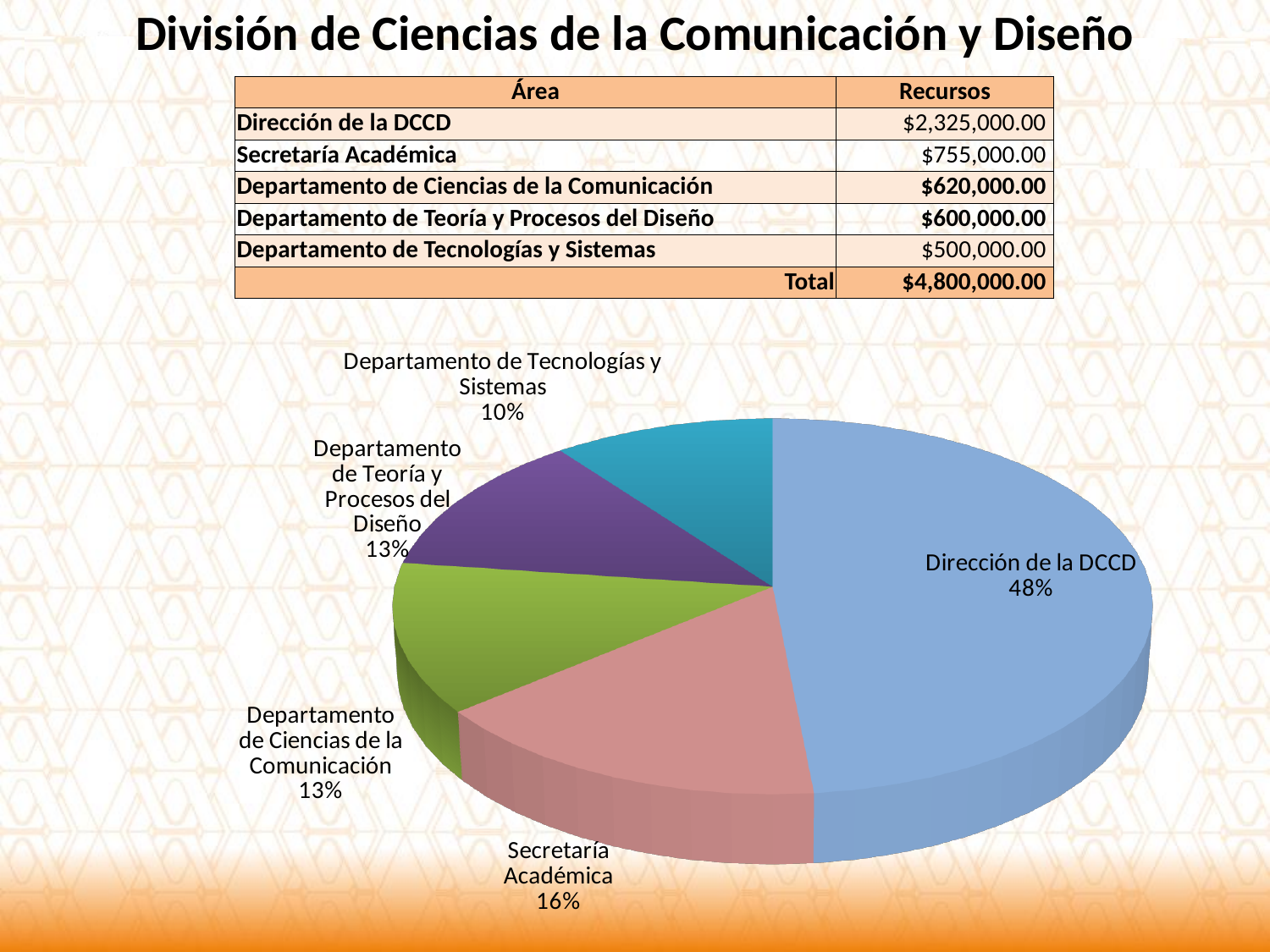
What share of the pie does Departamento de Tecnologías y Sistemas hold? 10% Which slice of the pie chart is the largest? Dirección de la DCCD What percentage is shown for Departamento de Teoría y Procesos del Diseño in the pie chart? 13% What kind of chart is shown on the slide? pie chart How many slices does the pie chart have? 5 What share of the pie does Secretaría Académica hold? 16% What percentage is shown for Departamento de Ciencias de la Comunicación in the pie chart? 13% Which slice is larger, Secretaría Académica or Departamento de Tecnologías y Sistemas? Secretaría Académica What share of the pie does Dirección de la DCCD hold? 48% By how many percentage points does the Dirección de la DCCD slice exceed the Secretaría Académica slice? 32 percentage points Which slice of the pie chart is the smallest? Departamento de Tecnologías y Sistemas What is the title of the slide containing the pie chart? División de Ciencias de la Comunicación y Diseño